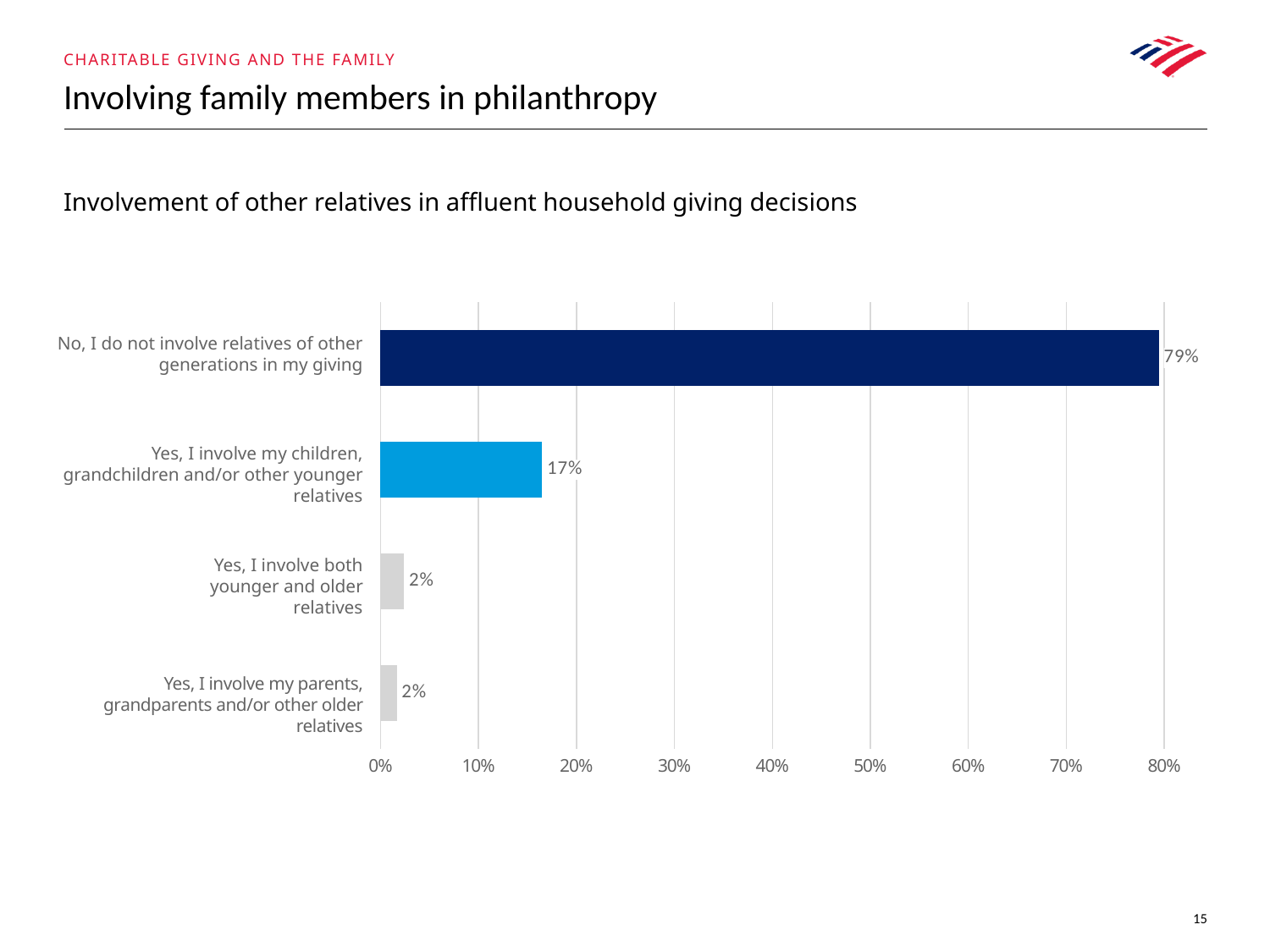
What type of chart is shown on the slide? Bar chart How many categories are shown in the chart? 4 What is the title of the chart? Involvement of other relatives in affluent household giving decisions Is the value for 'No, I do not involve relatives of other generations in my giving' greater or less than 70%? greater Which category has the highest value? No, I do not involve relatives of other generations in my giving What percentage of respondents involve their children, grandchildren and/or other younger relatives? 17% What is the difference between the share who do not involve relatives of other generations and the share who involve younger relatives? 62% What percentage of respondents say they do not involve relatives of other generations in their giving? 79% Is the value for 'Yes, I involve my children, grandchildren and/or other younger relatives' greater or less than 20%? less Which is larger: the share involving younger relatives or the share involving both younger and older relatives? Yes, I involve my children, grandchildren and/or other younger relatives What percentage of respondents involve both younger and older relatives? 2% What percentage of respondents involve their parents, grandparents and/or other older relatives? 2%